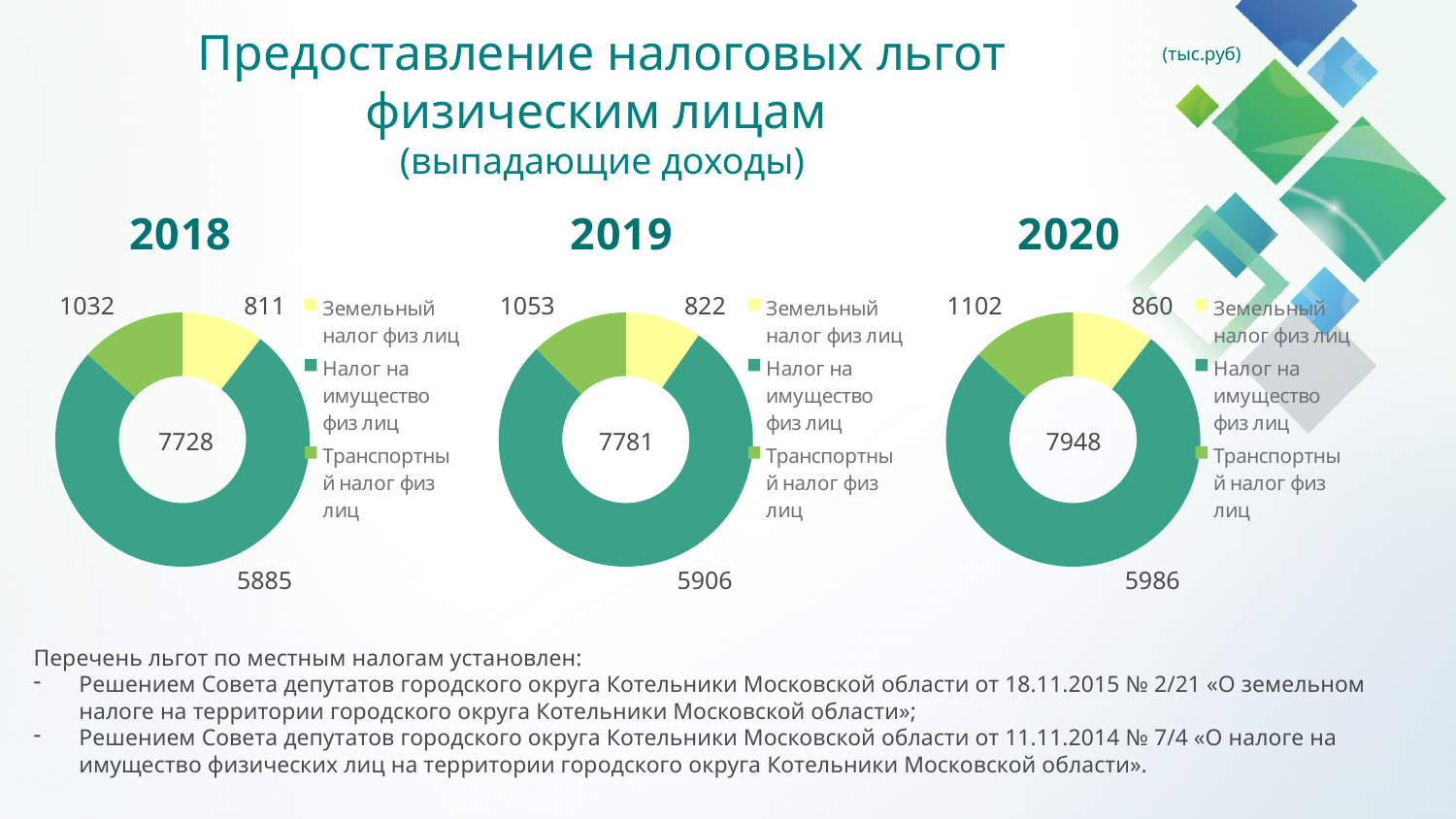
In the 2020 chart, what total is shown in the centre of the donut? 7948 In the 2019 chart, which category has the smallest slice? Земельный налог физ лиц What kind of chart is used for each year on the slide? Donut (pie) chart In the 2018 chart, which category has the largest slice? Налог на имущество физ лиц What unit is indicated in the top right of the slide for the chart values? тыс.руб In the 2018 chart, what is the value for Налог на имущество физ лиц? 5885 In the 2019 chart, what is the value for Земельный налог физ лиц? 822 In the 2020 chart, what is the value for Транспортный налог физ лиц? 1102 How many categories does the legend of the 2018 chart list? 3 In the 2020 chart, what is the difference between Транспортный налог физ лиц and Земельный налог физ лиц? 242 In the 2019 chart, which is larger: Транспортный налог физ лиц or Земельный налог физ лиц? Транспортный налог физ лиц Across the 2018, 2019 and 2020 charts, does the value for Налог на имущество физ лиц rise or fall over the years? Rise